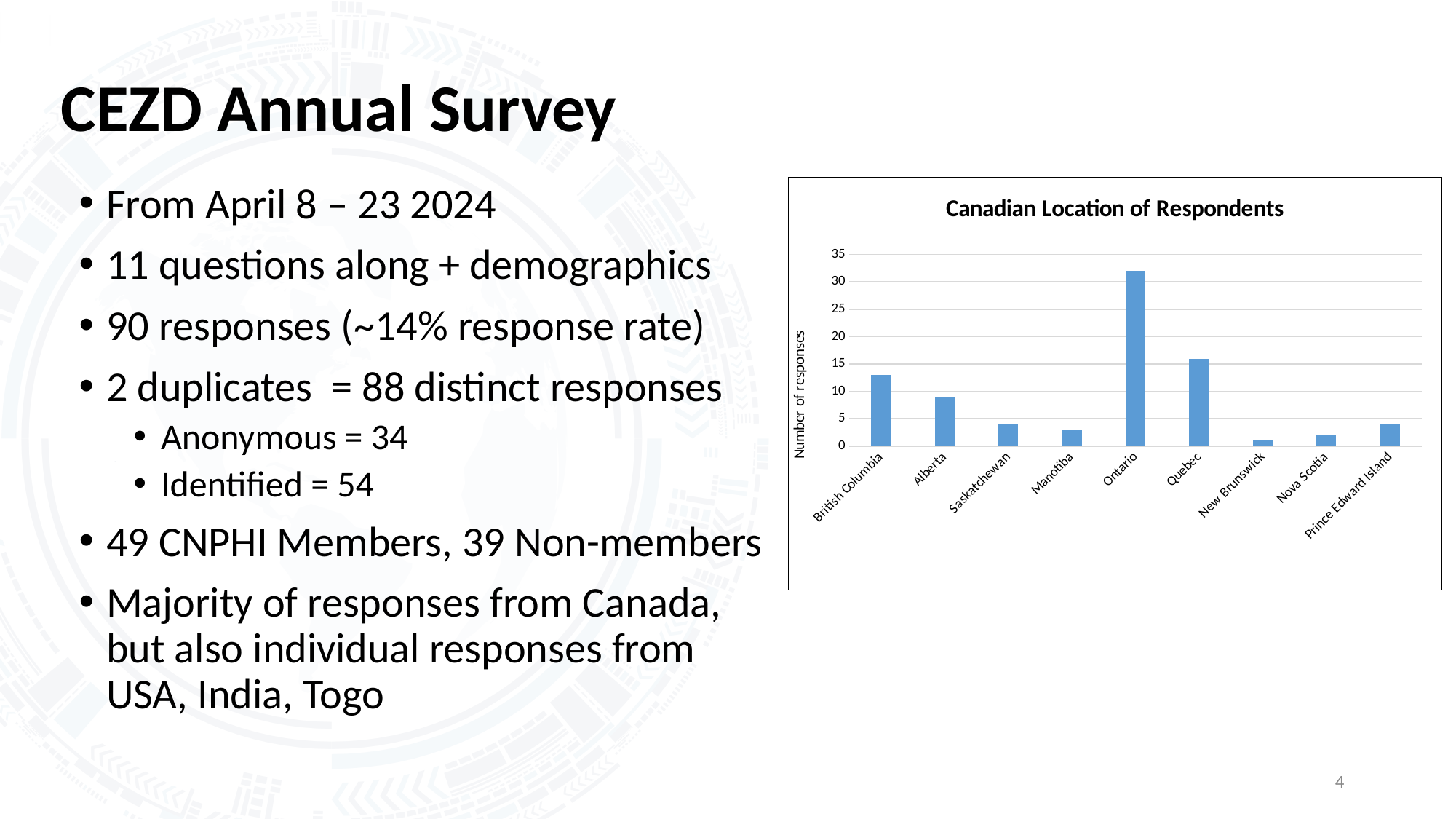
Which province has the highest number of responses? Ontario Which has more responses, British Columbia or Alberta? British Columbia What is the label on the vertical axis of the chart? Number of responses Is the number of responses for British Columbia greater or less than 10? greater Is the number of responses for Ontario greater or less than 30? greater What is the title of the chart? Canadian Location of Respondents Is the number of responses for Quebec greater or less than 10? greater Which has more responses, Ontario or Quebec? Ontario What type of chart is shown on the slide? Bar chart How many provinces are shown on the x axis of the chart? 9